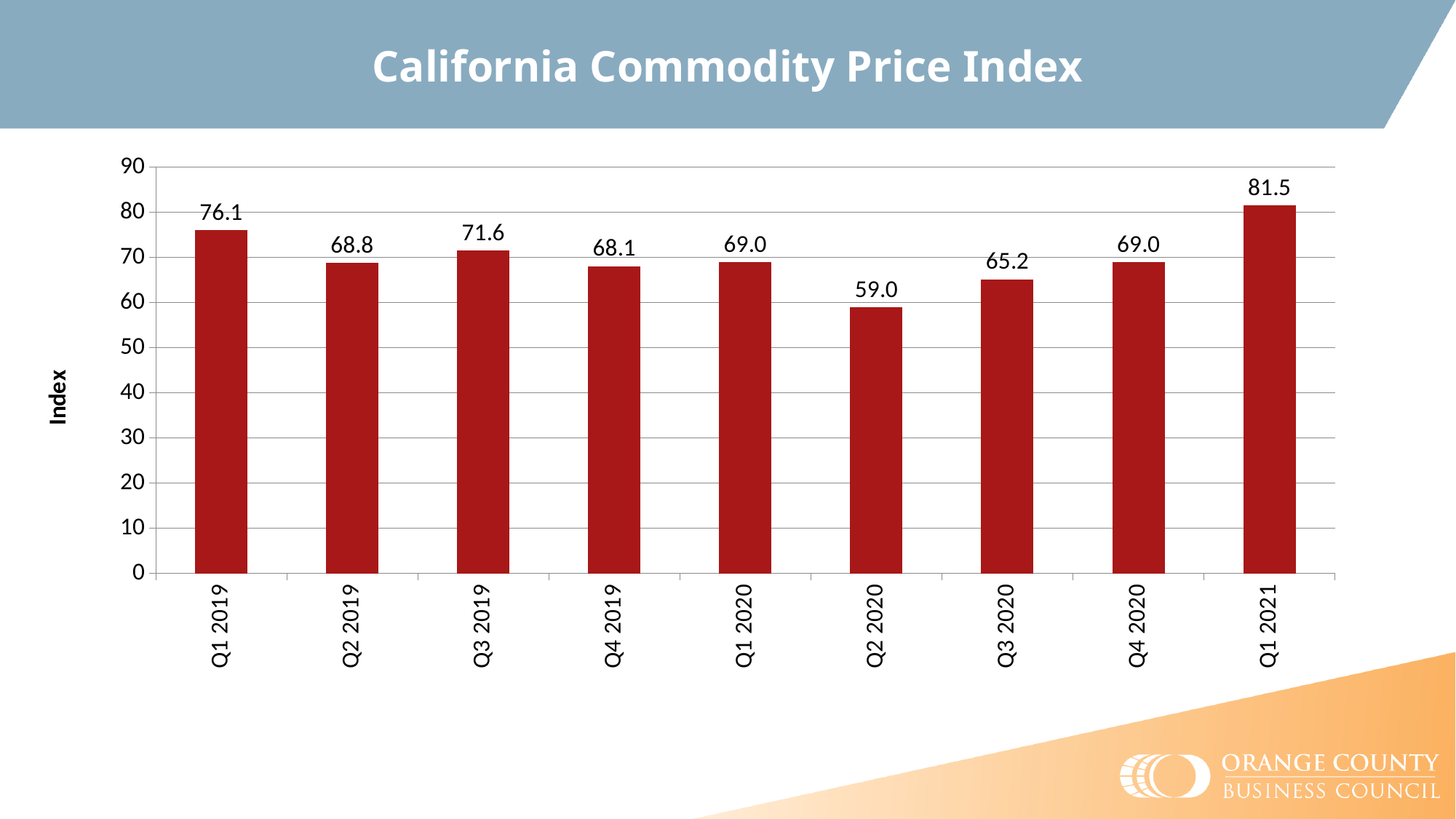
What kind of chart is shown on the slide? bar chart Which quarter has the lowest index value? Q2 2020 Is the index value for Q2 2020 greater or less than 60? less What is the index value for Q3 2020? 65.2 What is the label on the vertical axis of the chart? Index What is the difference between the index values for Q1 2021 and Q2 2020? 22.5 What is the California Commodity Price Index value for Q1 2019? 76.1 Which is larger, the index value for Q3 2019 or Q4 2019? Q3 2019 What is the index value for Q2 2020? 59.0 How many quarters are shown on the chart? 9 Which quarter has the highest index value? Q1 2021 What is the difference between the index values for Q1 2019 and Q2 2019? 7.3